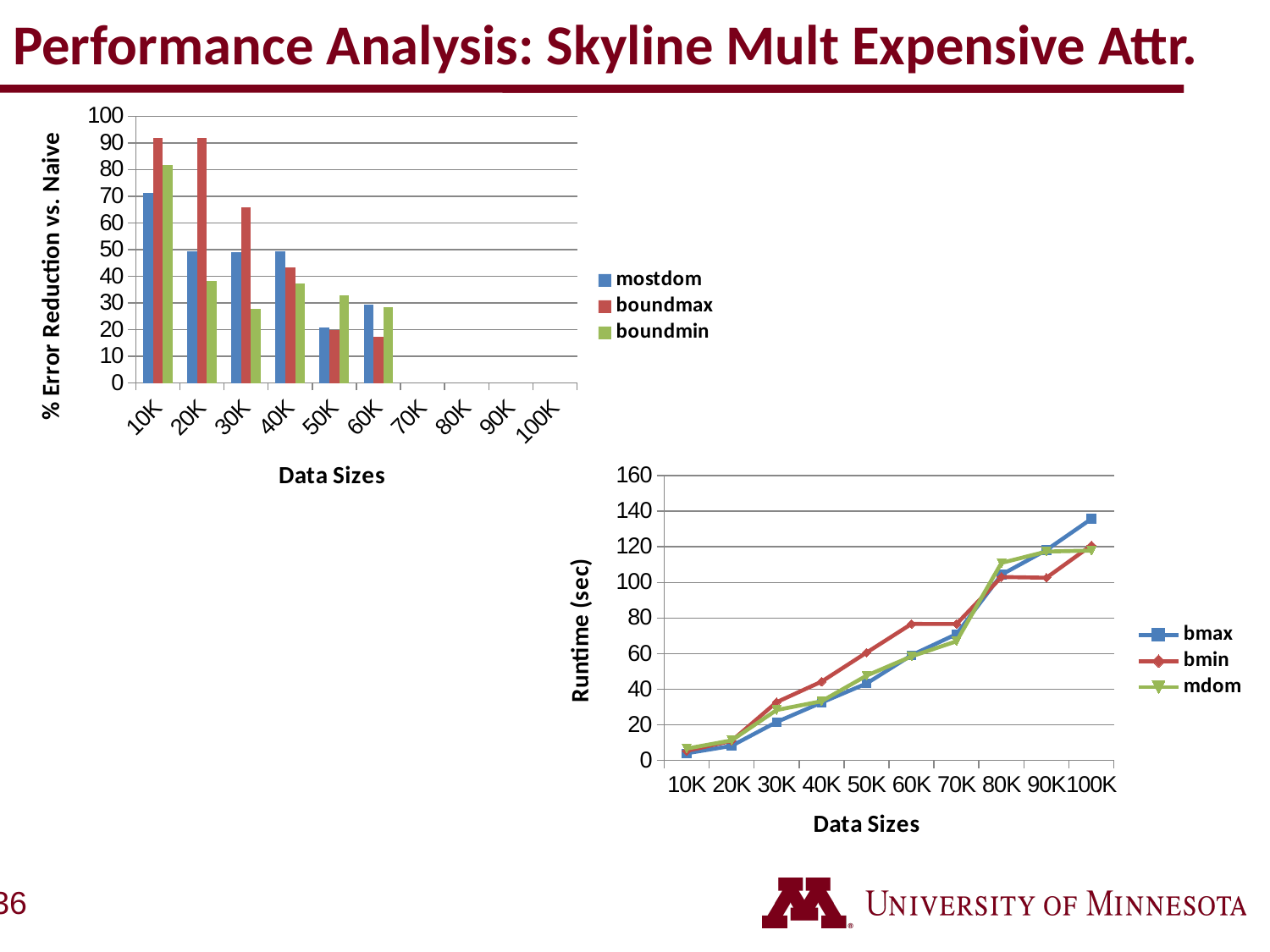
What kind of chart is the bottom-right chart showing Runtime (sec)? line chart In the top-left bar chart, is the value for boundmin at 30K greater or less than 40? less In the top-left bar chart, how many series does the legend list? 3 In the bottom-right line chart, which series has the highest value at 60K? bmin In the bottom-right line chart, do the runtime values rise or fall as data size increases from 10K to 100K? rise In the bottom-right line chart, is the value for bmax at 100K greater or less than 120? greater In the bottom-right line chart, how many series does the legend list? 3 In the top-left bar chart, is the value for boundmax at 10K greater or less than 80? greater In the top-left bar chart, which series has the lowest value at 60K? boundmax In the top-left bar chart, which series has the highest value at 10K? boundmax What kind of chart is the top-left chart showing % Error Reduction vs. Naive? bar chart In the top-left bar chart, at 30K, which is larger: boundmax or mostdom? boundmax